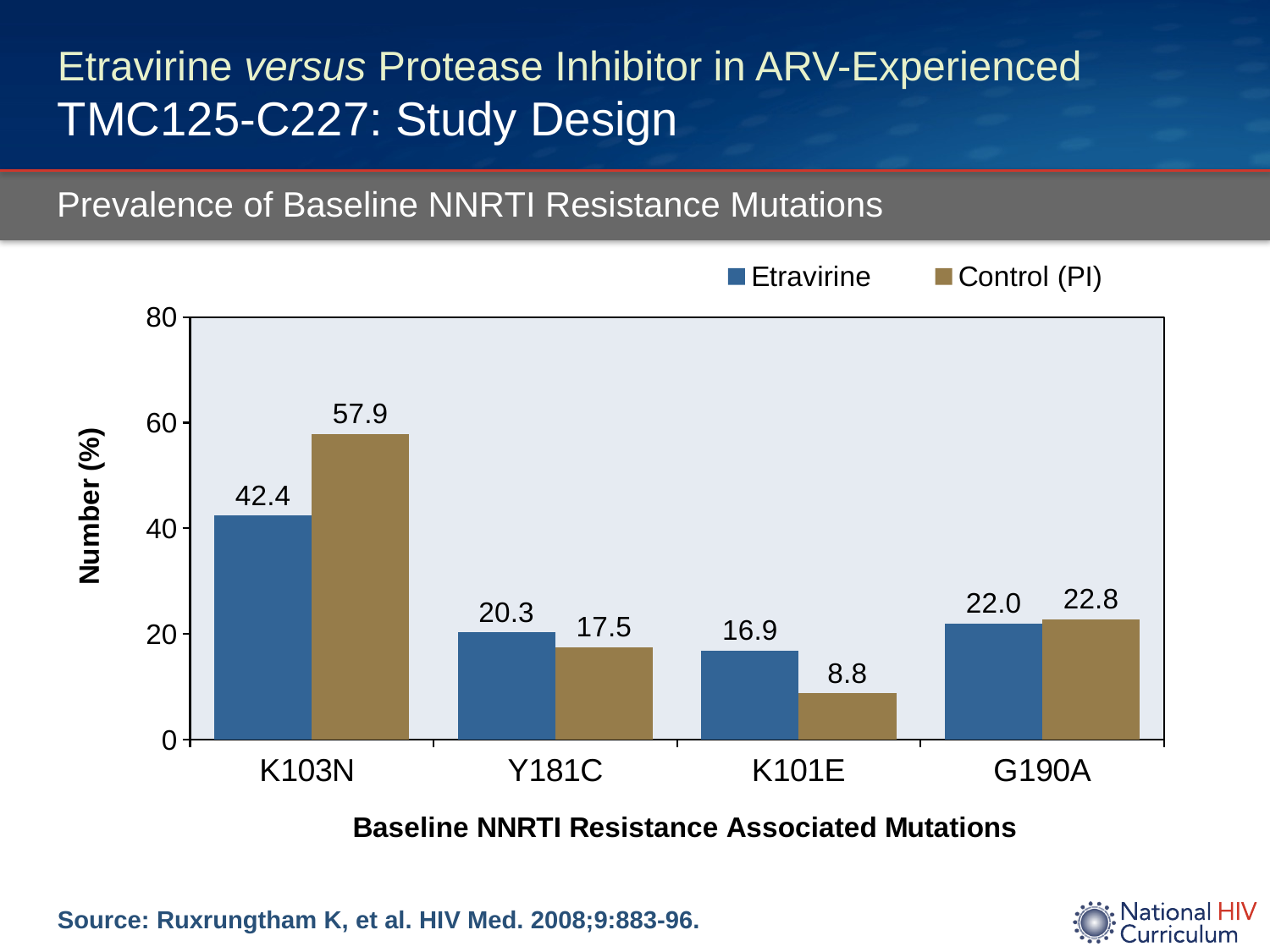
How many mutation categories are shown on the x axis? 4 How many series does the legend list? 2 Which mutation has the highest Control (PI) value? K103N What kind of chart is shown on the slide? Bar chart What is the Control (PI) value for K101E? 8.8 What is the label of the y axis? Number (%) Is the Etravirine value for K103N greater or less than 40? greater What is the difference between the Control (PI) and Etravirine values for K103N? 15.5 What is the Etravirine value for K103N? 42.4 Which mutation has the lowest Etravirine value? K101E What is the Control (PI) value for G190A? 22.8 For Y181C, which is larger: the Etravirine value or the Control (PI) value? Etravirine